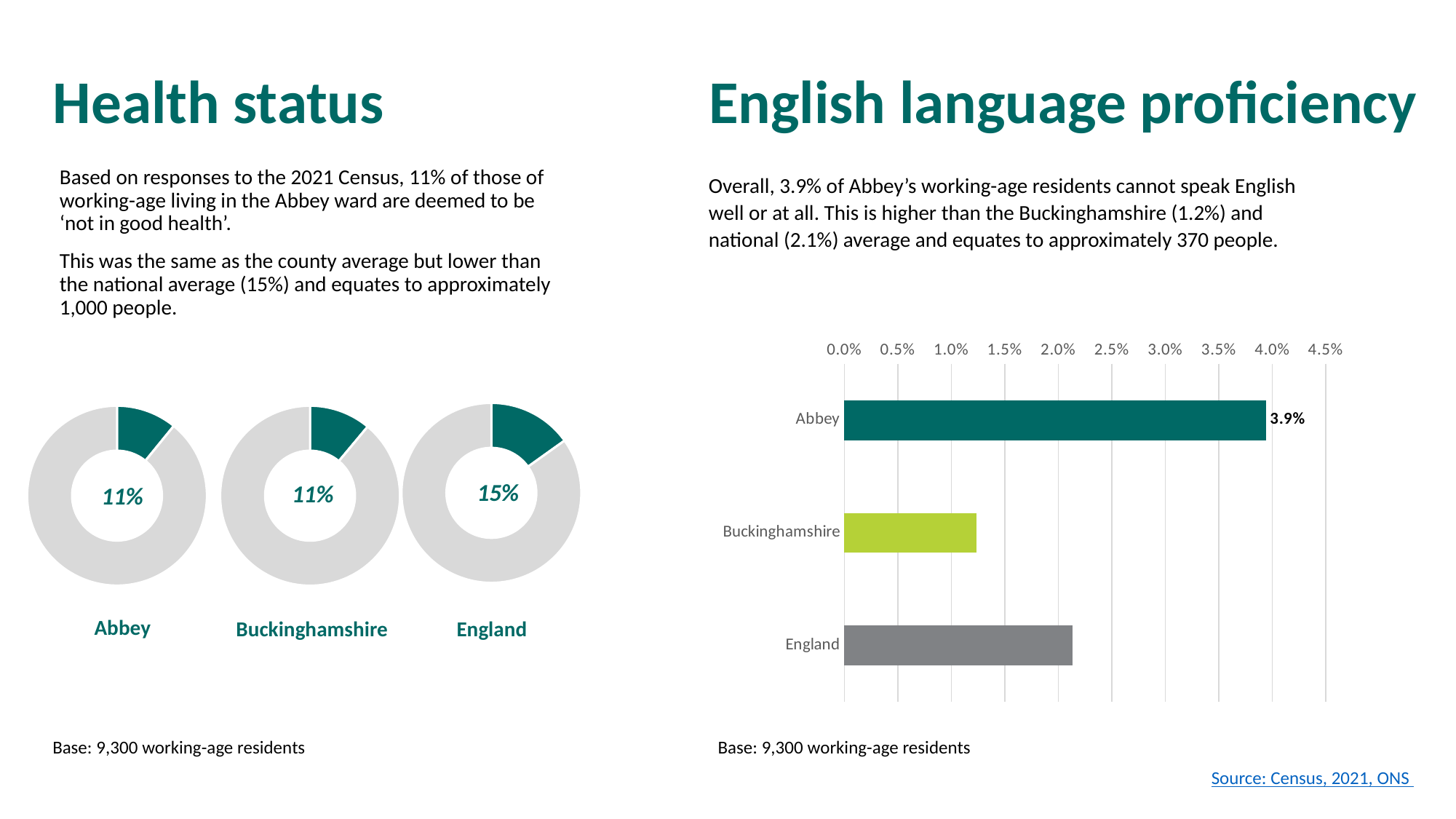
In the English language proficiency bar chart, which area has the highest value? Abbey In the English language proficiency bar chart, which is larger, the value for Abbey or the value for England? Abbey In the Health status donut charts, what percentage is shown for England? 15% In the English language proficiency bar chart, is the value for England greater or less than 2.5%? less What kind of chart is used for English language proficiency? bar chart In the English language proficiency bar chart, is the value for Buckinghamshire greater or less than 1.5%? less In the Health status donut charts, what is the difference between the England value and the Abbey value? 4 percentage points In the Health status donut charts, what percentage is shown for Abbey? 11% In the English language proficiency bar chart, which area has the lowest value? Buckinghamshire In the English language proficiency bar chart, what is the value for Abbey? 3.9% How many donut charts are shown under the Health status heading? 3 In the Health status donut charts, which area has the highest percentage not in good health? England